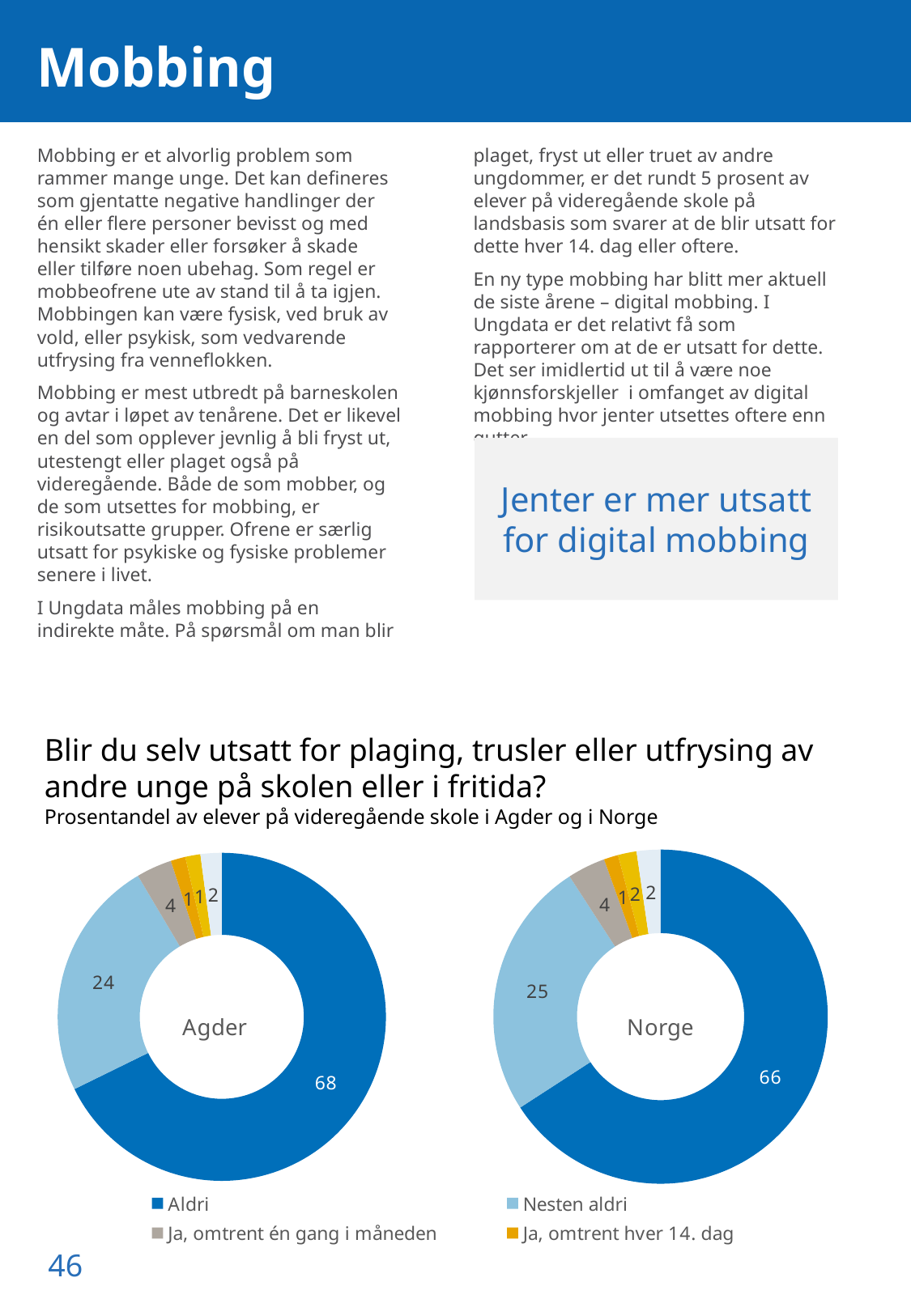
In the Norge chart, what is the value for "Ja, omtrent én gang i måneden"? 4 In the Norge chart, what is the value for "Nesten aldri"? 25 Which chart has the larger value for "Aldri", Agder or Norge? Agder What is the difference between the "Aldri" value in the Agder chart and the "Aldri" value in the Norge chart? 2 In the Agder chart, what percentage of students answered "Aldri"? 68 In the Agder chart, what is the value for "Ja, omtrent én gang i måneden"? 4 In the Agder chart, which category has the largest share? Aldri In the Norge chart, what percentage of students answered "Aldri"? 66 What kind of chart is used to show the Agder and Norge data? Doughnut (pie) chart Which chart has the larger value for "Nesten aldri", Agder or Norge? Norge In the Agder chart, what is the value for "Nesten aldri"? 24 How many slices does the Agder chart have? 6